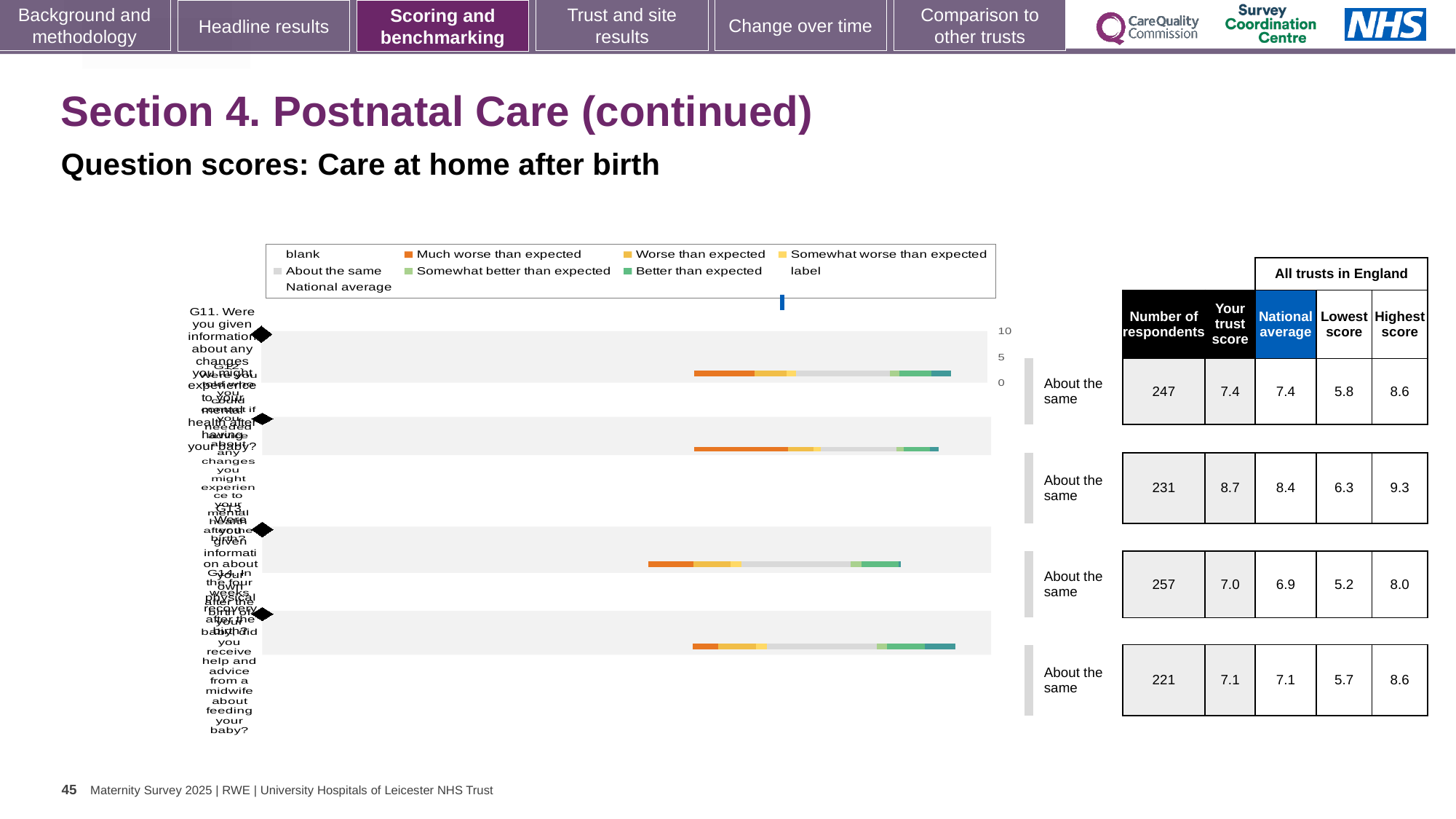
How many rows in the chart are labelled "About the same"? 4 In the table to the right of the chart, what is the difference between the trust score and the national average in the second row? 0.3 What colour does the legend use for "Much worse than expected"? orange In the table to the right of the chart, what is the smallest "Lowest score" value shown? 5.2 In the table to the right of the chart, what is the "Your trust score" value for the second row? 8.7 How many question rows (bars) does the chart show? 4 In the table to the right of the chart, what is the number of respondents for the first row? 247 What kind of chart is shown on the slide? bar chart In the table to the right of the chart, is the trust score or the national average larger in the third row? trust score (7.0) What is the highest tick value shown on the chart's score axis? 10 In the table to the right of the chart, which row has the highest "Your trust score"? the second row (8.7) In the table to the right of the chart, what is the largest "Highest score" value shown? 9.3